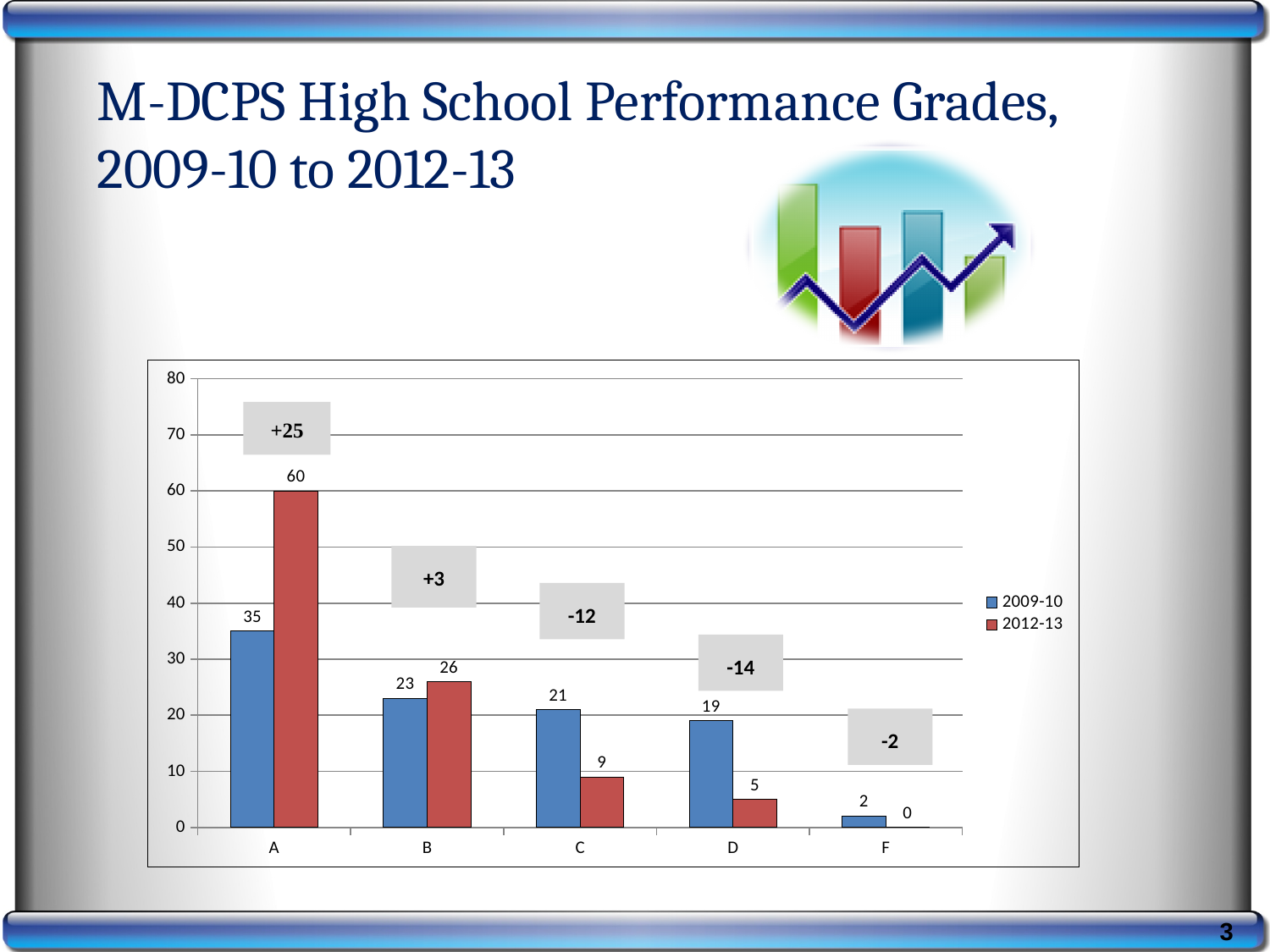
What is the value for grade A in the 2012-13 series? 60 Which grade has the lowest value in the 2009-10 series? F What kind of chart is shown on the slide? bar chart Which is larger for grade B: the 2009-10 value or the 2012-13 value? 2012-13 What is the value for grade D in the 2009-10 series? 19 What change label is shown above the bars for grade D? -14 Which grade has the highest value in the 2012-13 series? A What is the difference between the 2012-13 and 2009-10 values for grade C? -12 Is the 2012-13 value for grade A greater or less than 50? greater What is the value for grade F in the 2012-13 series? 0 How many series does the legend list? 2 How many grade categories are shown on the x axis? 5